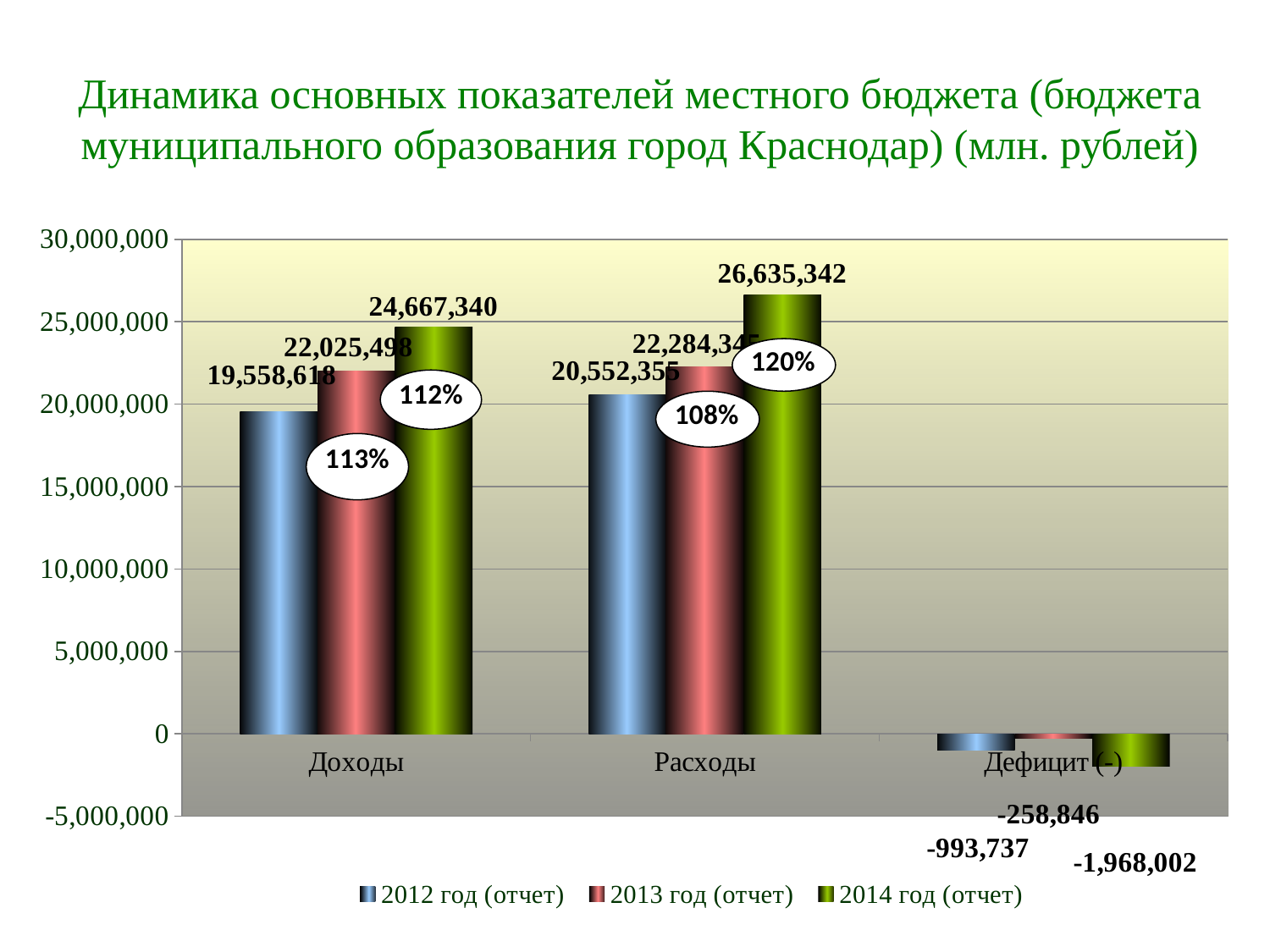
What percentage is shown in the bubble next to the 2014 Расходы bar? 120% What is the value for Доходы in 2014 год (отчет)? 24,667,340 What is the value for Дефицит (-) in 2013 год (отчет)? -258,846 Which year has the highest value for Расходы? 2014 год (отчет) By how much did Доходы grow from 2012 год (отчет) to 2014 год (отчет)? 5,108,722 What is the value for Расходы in 2012 год (отчет)? 20,552,355 Do the values for Доходы rise or fall from 2012 to 2014? rise How many series does the legend list? 3 What is the value for Дефицит (-) in 2014 год (отчет)? -1,968,002 In 2012 год (отчет), which is larger: Доходы or Расходы? Расходы What is the value for Расходы in 2014 год (отчет)? 26,635,342 What is the difference between Расходы and Доходы in 2014 год (отчет)? 1,968,002